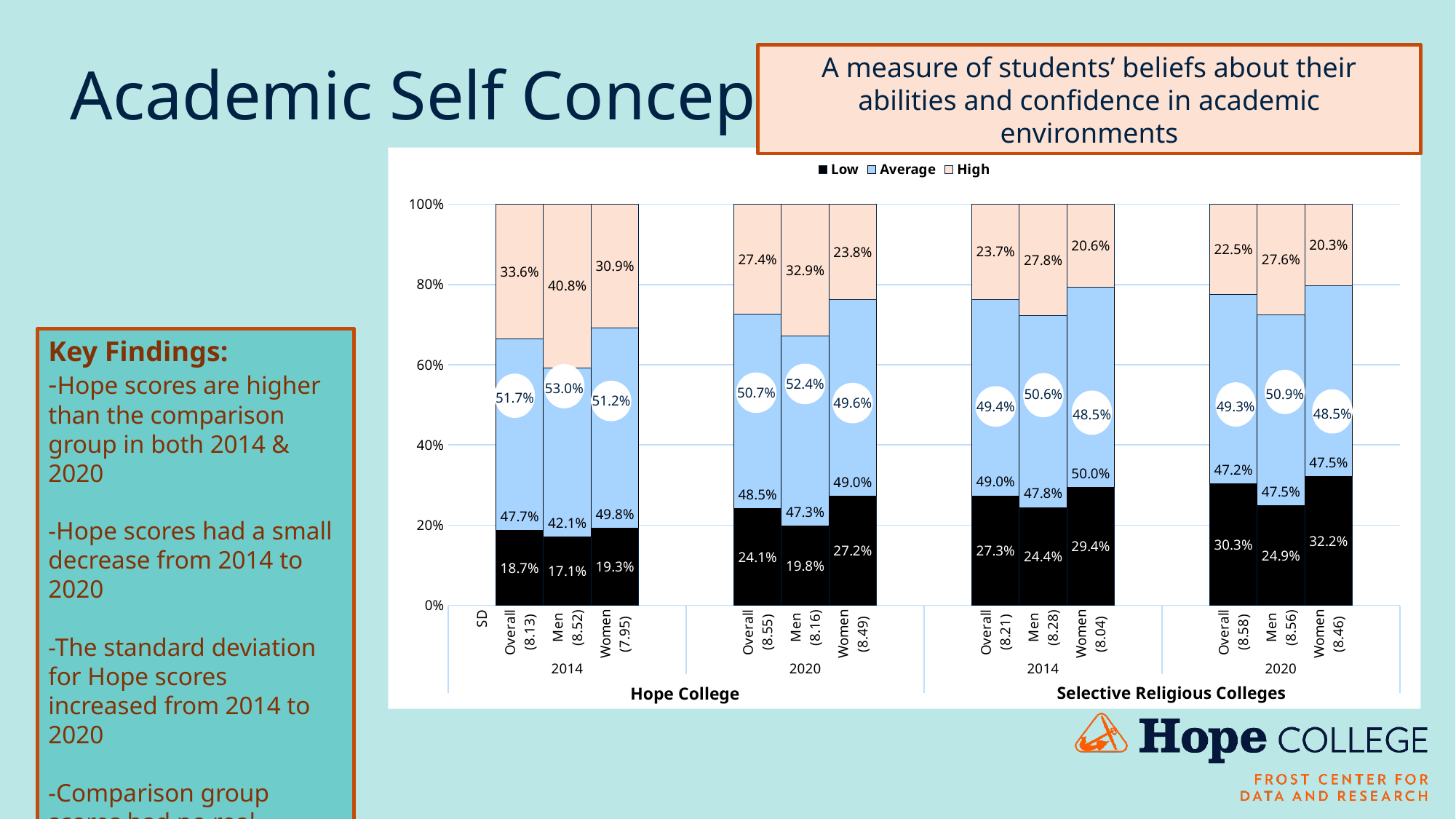
Which has the larger Low percentage for Overall in 2020: Hope College or Selective Religious Colleges? Selective Religious Colleges Which bar has the highest Low percentage? Selective Religious Colleges Women 2020 (32.2%) What are the three legend entries in the chart? Low, Average, High How many stacked bars are plotted in the chart? 12 What is the Low percentage for Hope College Men in 2014? 17.1% Which bar has the lowest Low percentage? Hope College Men 2014 (17.1%) What is the High percentage for Hope College Men in 2014? 40.8% What kind of chart is shown on the slide? Stacked bar chart How many series does the chart legend list? 3 What is the Low percentage for Selective Religious Colleges Women in 2020? 32.2% What is the difference in the High percentage between Hope College Men in 2014 and Hope College Men in 2020? 7.9 percentage points Which bar has the highest High percentage? Hope College Men 2014 (40.8%)